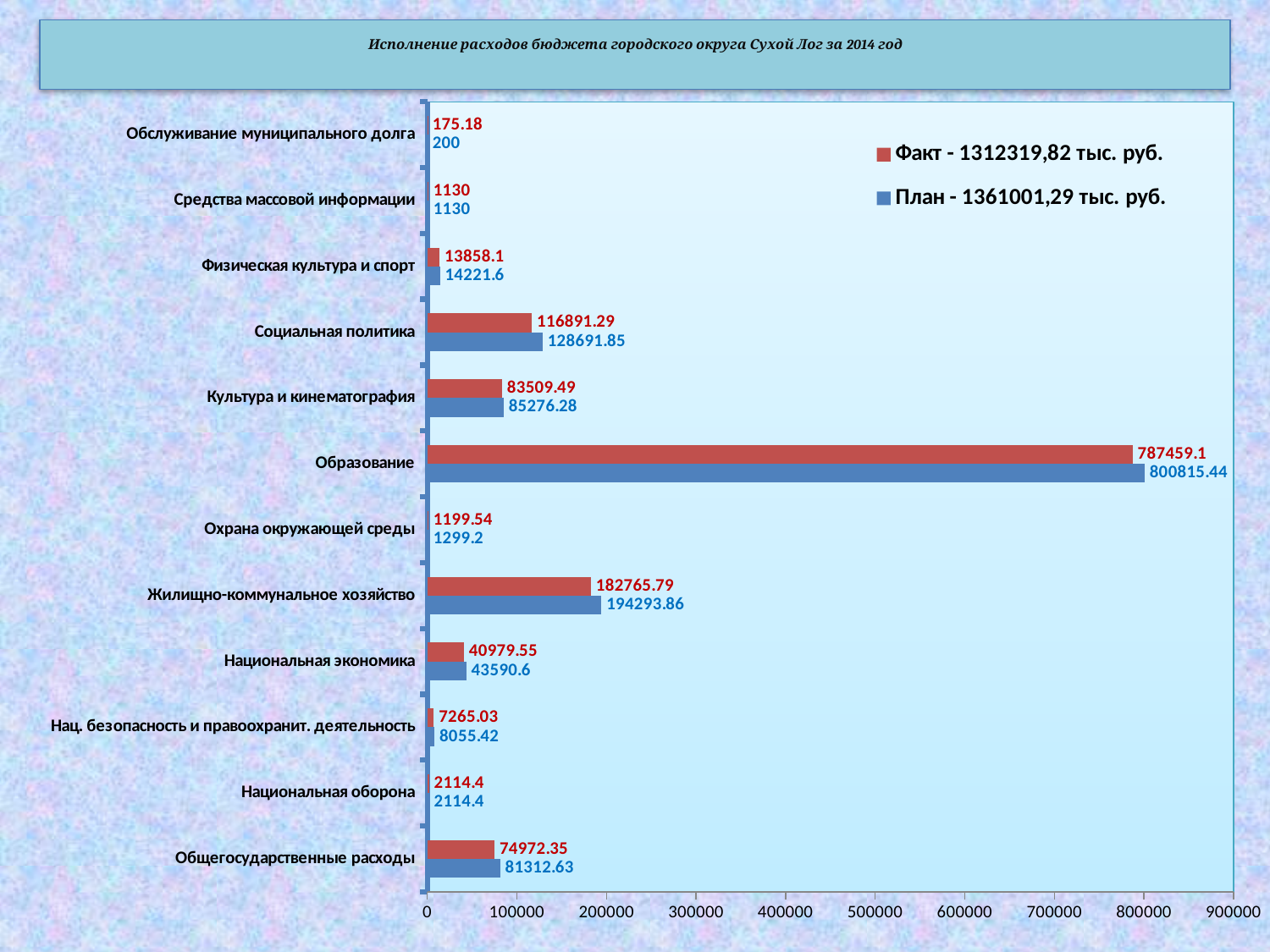
How many categories are shown on the chart? 12 What kind of chart is shown on the slide? bar chart Which category has the highest Факт value? Образование What is the difference between the План and Факт values for Образование? 13356.34 Which category has the lowest План value? Обслуживание муниципального долга What is the Факт value for Образование? 787459.1 What is the difference between the План and Факт values for Социальная политика? 11800.56 What is the План value for Жилищно-коммунальное хозяйство? 194293.86 What is the Факт value for Средства массовой информации? 1130 Is the Факт value for Образование greater or less than 700000? greater How many series does the legend list? 2 For Национальная экономика, which is larger: the Факт value or the План value? План